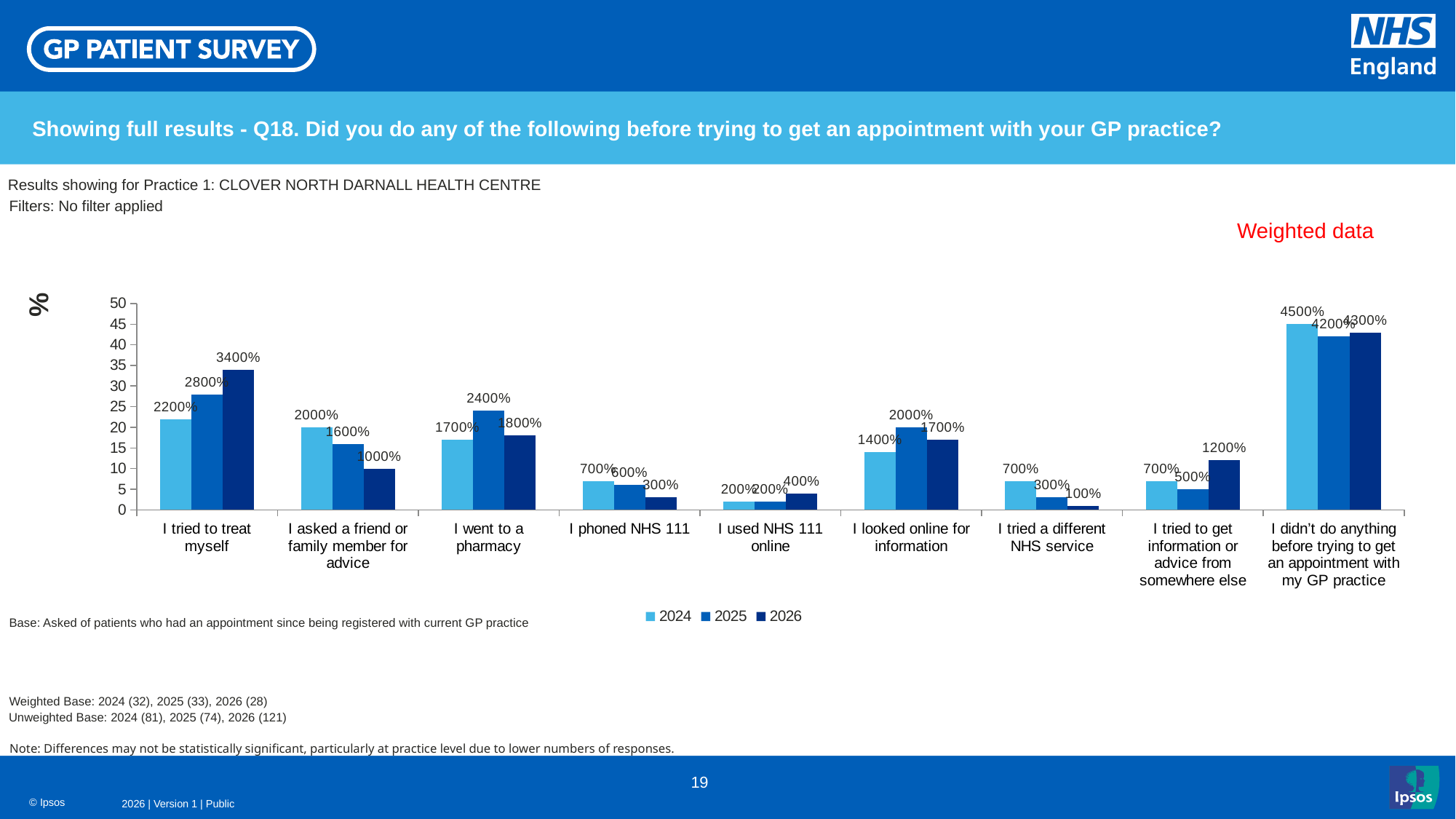
What is the 2024 value for 'I went to a pharmacy'? 1700% What is the difference between the 2026 and 2024 values for 'I tried to treat myself', as labelled on the chart? 1200% Which category has the lowest 2026 value? I tried a different NHS service Which is larger for 'I asked a friend or family member for advice': the 2024 value or the 2026 value? 2024 What kind of chart is shown on the slide? Bar chart Do the values for 'I tried to treat myself' rise or fall from 2024 to 2026? Rise What is the 2025 value for 'I looked online for information'? 2000% How many series does the legend list? 3 How many categories are shown on the x axis? 9 Which series is shown in the darkest blue in the legend? 2026 What is the 2026 value for 'I tried to treat myself'? 3400% Which category has the highest 2024 value? I didn't do anything before trying to get an appointment with my GP practice